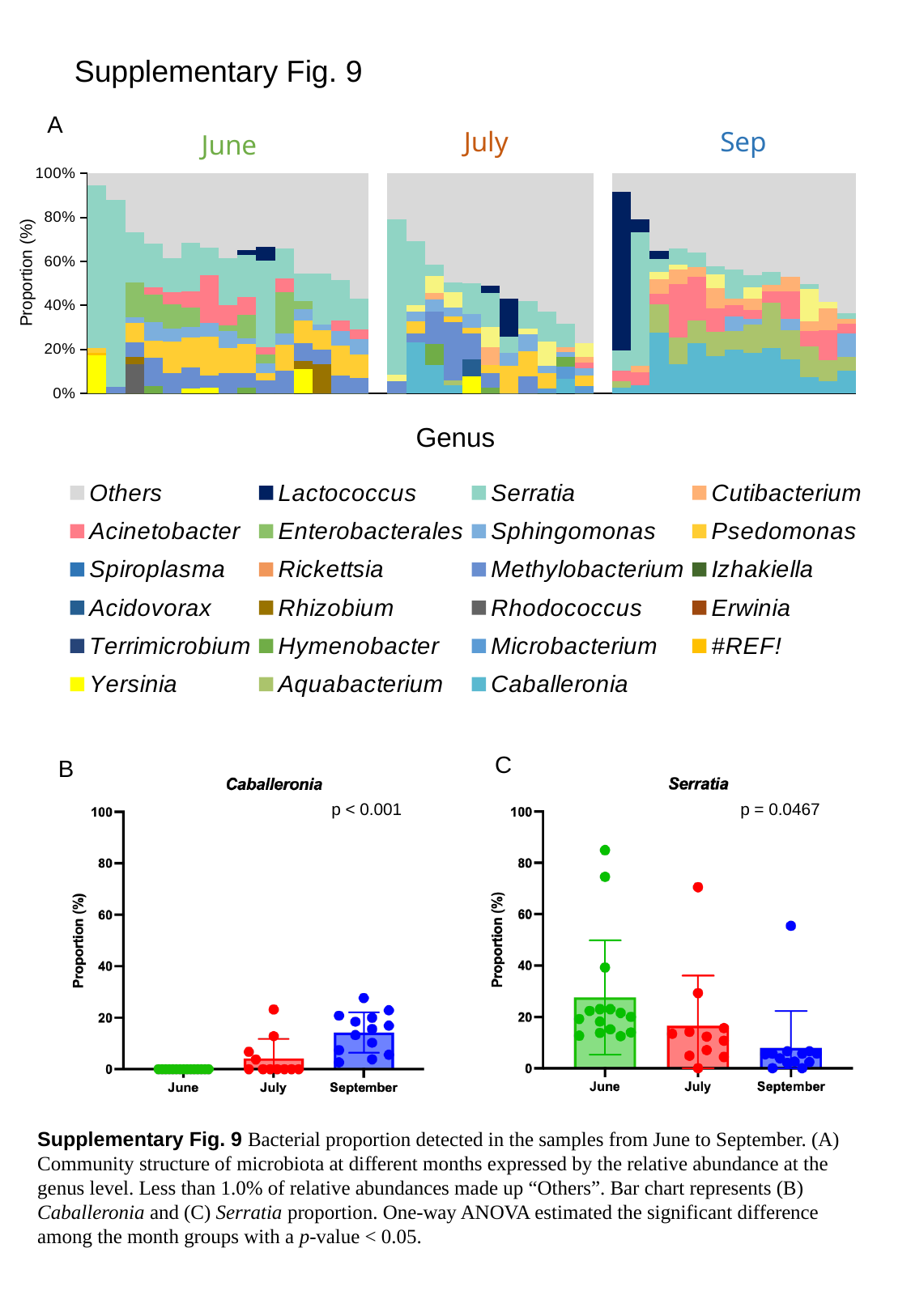
How many month groups are shown in panel A? 3 In the Caballeronia chart (panel B), which month has the lowest bar? June In the Serratia chart (panel C), which bar is larger, June or September? June How many categories are on the x axis of the Serratia chart (panel C)? 3 In the Caballeronia chart (panel B), is the bar for September greater or less than 20? less In the Serratia chart (panel C), is the bar for June greater or less than 20? greater In the Caballeronia chart (panel B), which month has the highest bar? September In the Caballeronia chart (panel B), do the bar values rise or fall from June to September? rise How many genus entries does the legend of panel A list? 23 What kind of chart is panel A? stacked bar chart In the Serratia chart (panel C), which month has the highest bar? June What p-value is printed on the Caballeronia chart (panel B)? p < 0.001